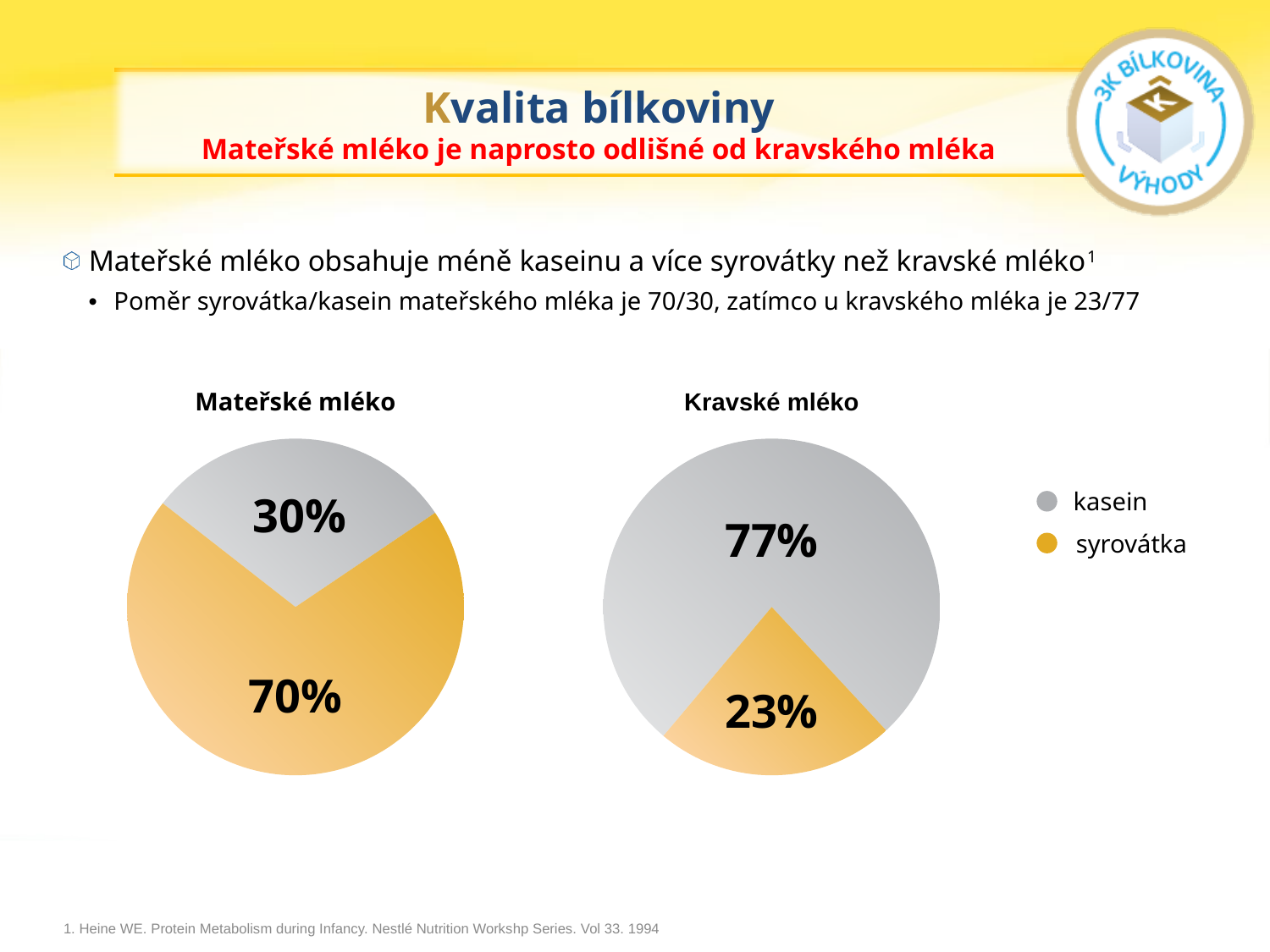
In the "Mateřské mléko" pie chart, what share is labelled for kasein? 30% In the "Kravské mléko" pie chart, what share is labelled for kasein? 77% In the "Kravské mléko" pie chart, what is the difference between the kasein and syrovátka shares? 54% How many slices does the "Kravské mléko" pie chart have? 2 According to the legend, which colour represents kasein? grey In the "Kravské mléko" pie chart, which slice is the smallest? syrovátka What kind of chart is used for "Mateřské mléko" and "Kravské mléko"? pie chart In the "Kravské mléko" pie chart, what share is labelled for syrovátka? 23% Which is larger: the syrovátka share in the "Mateřské mléko" chart or the syrovátka share in the "Kravské mléko" chart? Mateřské mléko In the "Mateřské mléko" pie chart, what share is labelled for syrovátka? 70% How many entries does the shared legend list? 2 In the "Mateřské mléko" pie chart, which slice is the largest? syrovátka